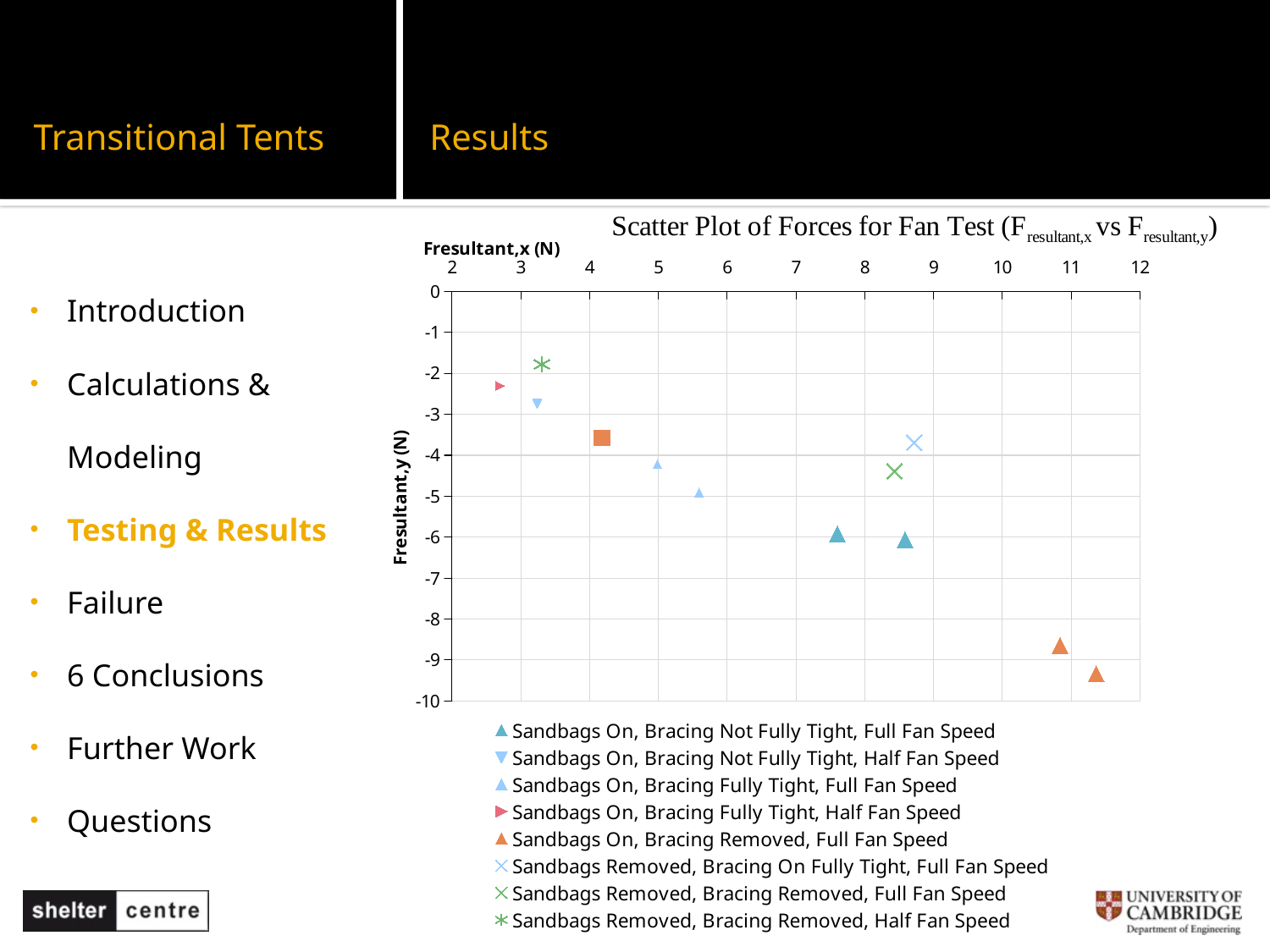
What kind of chart is shown on the slide? Scatter plot Is the Fresultant,x value for the Sandbags Removed, Bracing On Fully Tight, Full Fan Speed point greater or less than 8? greater Which series has the points with the lowest Fresultant,y values? Sandbags On, Bracing Removed, Full Fan Speed How many series does the legend list? 8 Which series has the points with the largest Fresultant,x values? Sandbags On, Bracing Removed, Full Fan Speed Which series has a larger Fresultant,x value: Sandbags Removed, Bracing Removed, Full Fan Speed or Sandbags Removed, Bracing Removed, Half Fan Speed? Sandbags Removed, Bracing Removed, Full Fan Speed Are the Fresultant,y values for the Sandbags On, Bracing Not Fully Tight, Full Fan Speed points greater or less than -5? less What is the label on the vertical axis of the chart? Fresultant,y (N) What is the title of the chart? Scatter Plot of Forces for Fan Test (Fresultant,x vs Fresultant,y) Is the Fresultant,x value for the Sandbags On, Bracing Fully Tight, Half Fan Speed point greater or less than 3? less Which series has the point with the highest Fresultant,y value (closest to 0)? Sandbags Removed, Bracing Removed, Half Fan Speed As Fresultant,x increases along the x axis, do the Fresultant,y values rise or fall? Fall